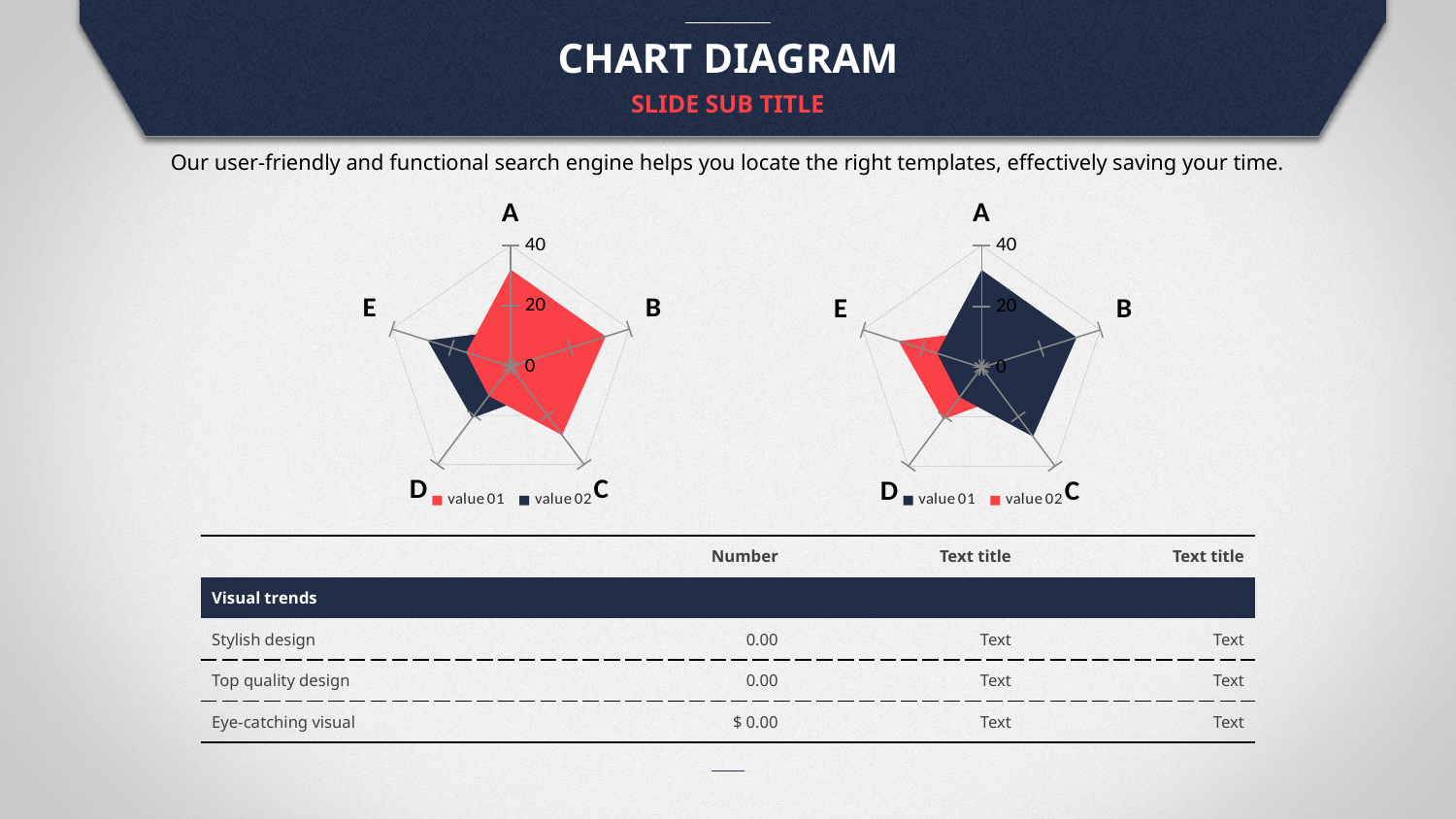
In the right radar chart, which series has the larger value at B, value 01 or value 02? value 01 In the left radar chart, is the value of value 01 at A greater or less than 20? greater What kind of chart is the left chart on the slide? radar chart In the left radar chart, which series has the larger value at E, value 01 or value 02? value 02 How many series does the legend of the right radar chart list? 2 In the left radar chart, which series has the larger value at A, value 01 or value 02? value 01 In the left radar chart, is the value of value 01 at B greater or less than 20? greater What is the highest axis tick value shown on the right radar chart? 40 How many categories does the left radar chart have? 5 In the right radar chart, is the value of value 01 at A greater or less than 20? greater What are the legend entries of the left radar chart? value 01, value 02